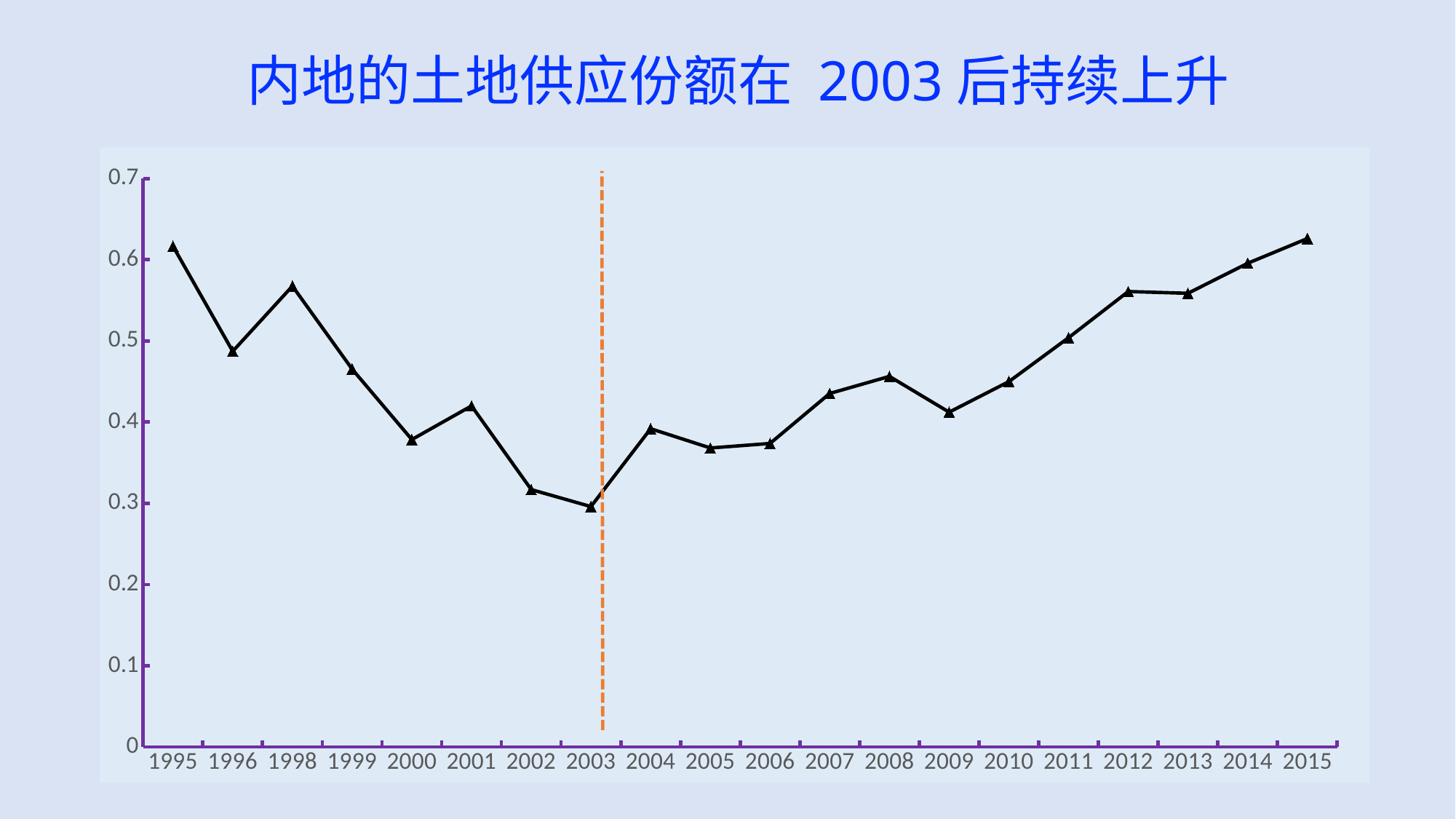
At which year is the orange dashed vertical line placed? 2003 What kind of chart is shown on the slide? line chart Do the values generally rise or fall from 2003 to 2015? rise Is the value for 2000 greater or less than 0.4? less Is the value for 1995 greater or less than 0.6? greater Which is larger, the value for 2012 or the value for 2009? 2012 How many years are plotted on the x axis? 20 Which is larger, the value for 1995 or the value for 1996? 1995 Which year has the lowest value? 2003 Is the value for 2008 greater or less than 0.4? greater